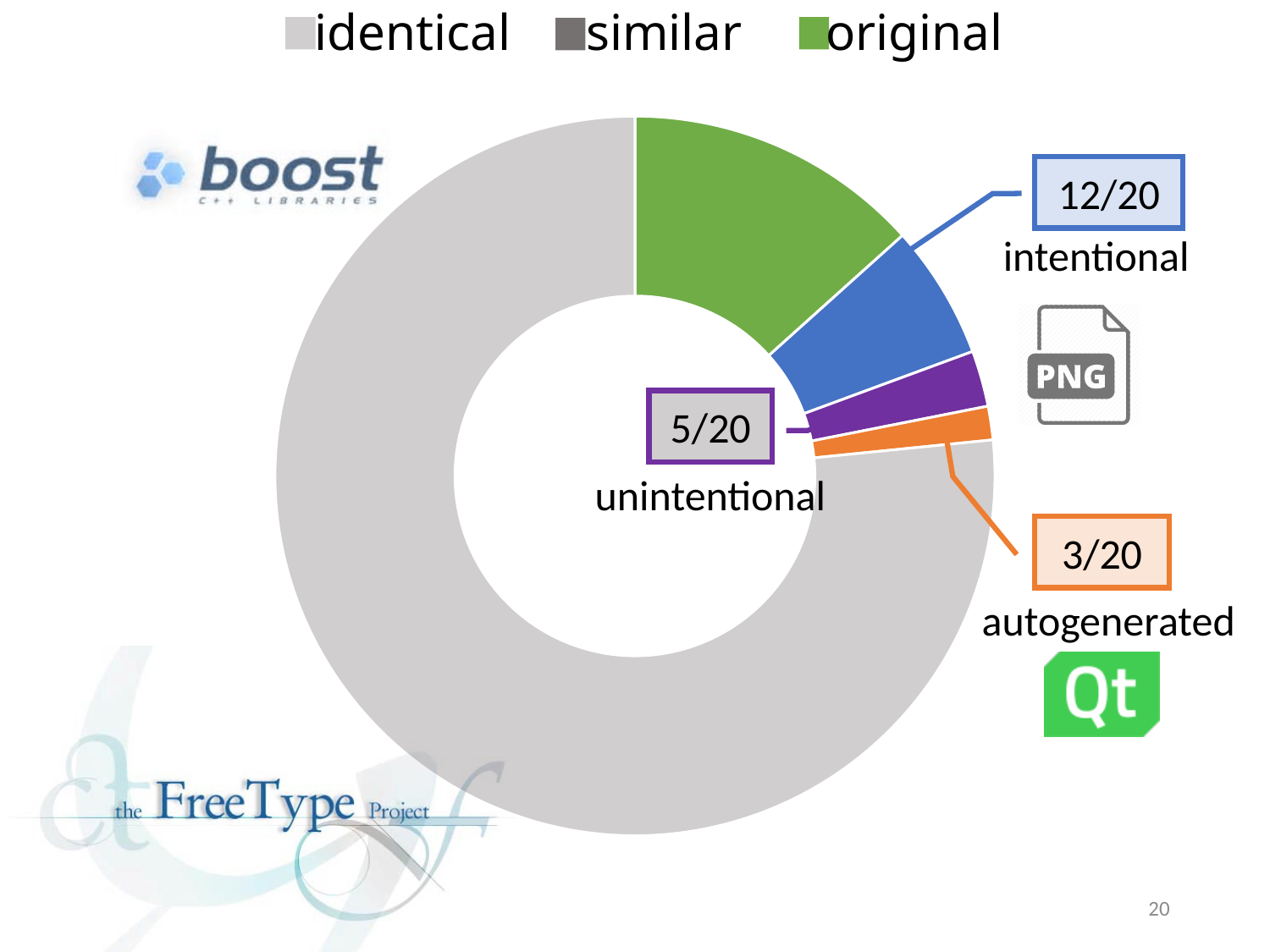
What value is labelled for the intentional segment? 12/20 Which legend category occupies the largest portion of the donut? identical Which of the labelled sub-segments (intentional, unintentional, autogenerated) has the smallest value? autogenerated Which colour represents the original category? green Which is larger, the intentional segment or the unintentional segment? intentional What is the difference between the intentional value and the unintentional value? 7/20 What are the three legend entries? identical, similar, original What kind of chart is shown on the slide? donut (pie) chart How many entries does the legend list? 3 Which of the labelled sub-segments (intentional, unintentional, autogenerated) has the largest value? intentional What value is labelled for the unintentional segment? 5/20 What value is labelled for the autogenerated segment? 3/20